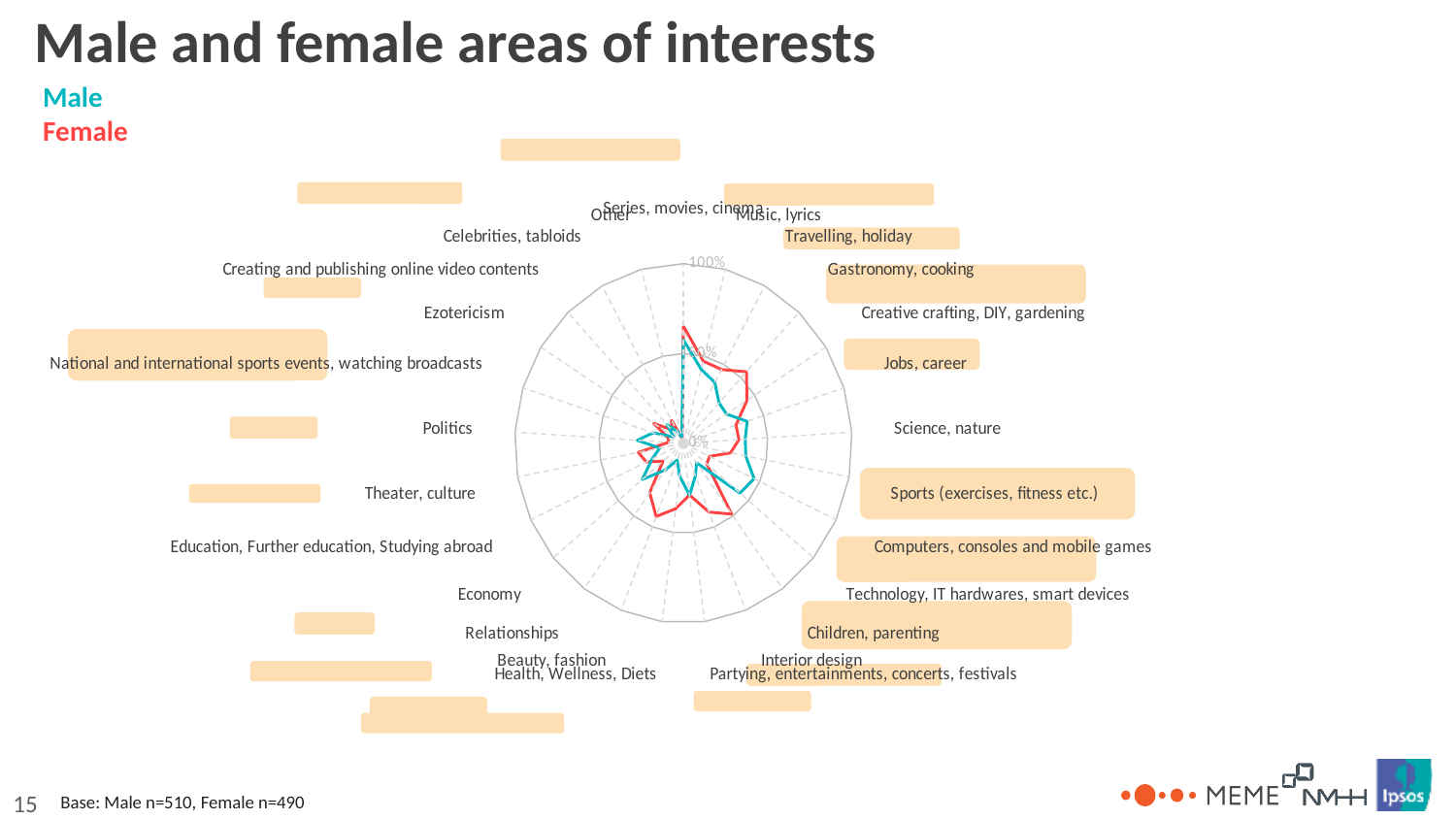
How many series does the chart plot? 2 Is the Female value for Politics greater or less than 50%? less What is the title of the slide's chart? Male and female areas of interests Is the Female value for Series, movies, cinema greater or less than 50%? greater Is the Male value for Series, movies, cinema greater or less than 50%? greater What kind of chart is shown on the slide? radar chart For Computers, consoles and mobile games, which series has the larger value, Male or Female? Male For Beauty, fashion, which series has the larger value, Male or Female? Female For Children, parenting, which series has the larger value, Male or Female? Female Which colour represents the Female series in the chart? red